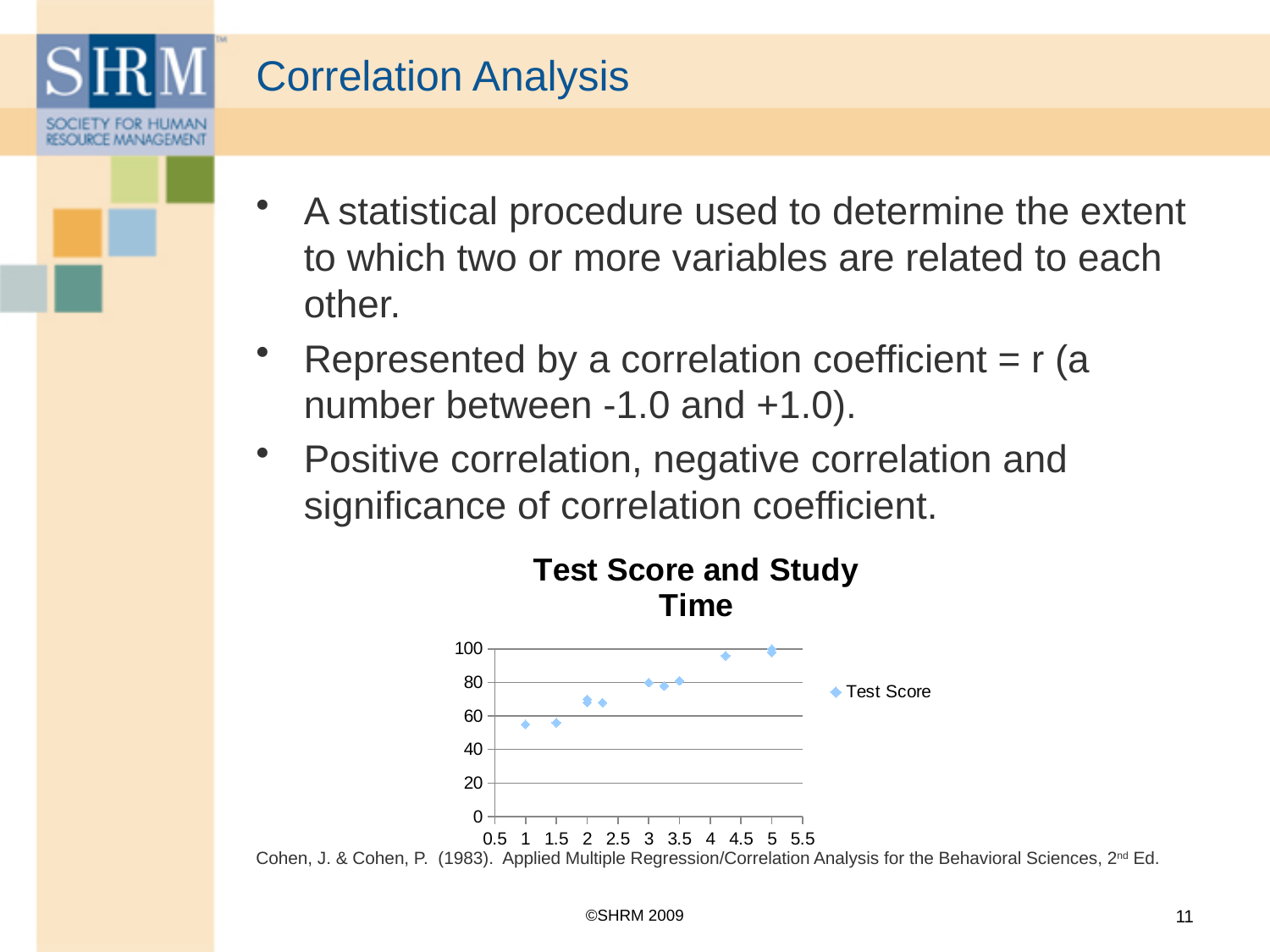
Do the test score values generally rise or fall as study time increases along the x axis? rise Is the test score for the point at study time 2 greater or less than 60? greater Is the test score for the point at study time 3 greater or less than 60? greater How many series does the chart's legend list? 1 Is the test score for the point at study time 5 greater or less than 80? greater What is the name of the series shown in the chart's legend? Test Score What kind of chart is shown on the slide? scatter chart What is the title of the chart on the slide? Test Score and Study Time Which has the higher test score: the point at study time 1 or the point at study time 5? the point at study time 5 What is the highest value shown on the chart's vertical axis? 100